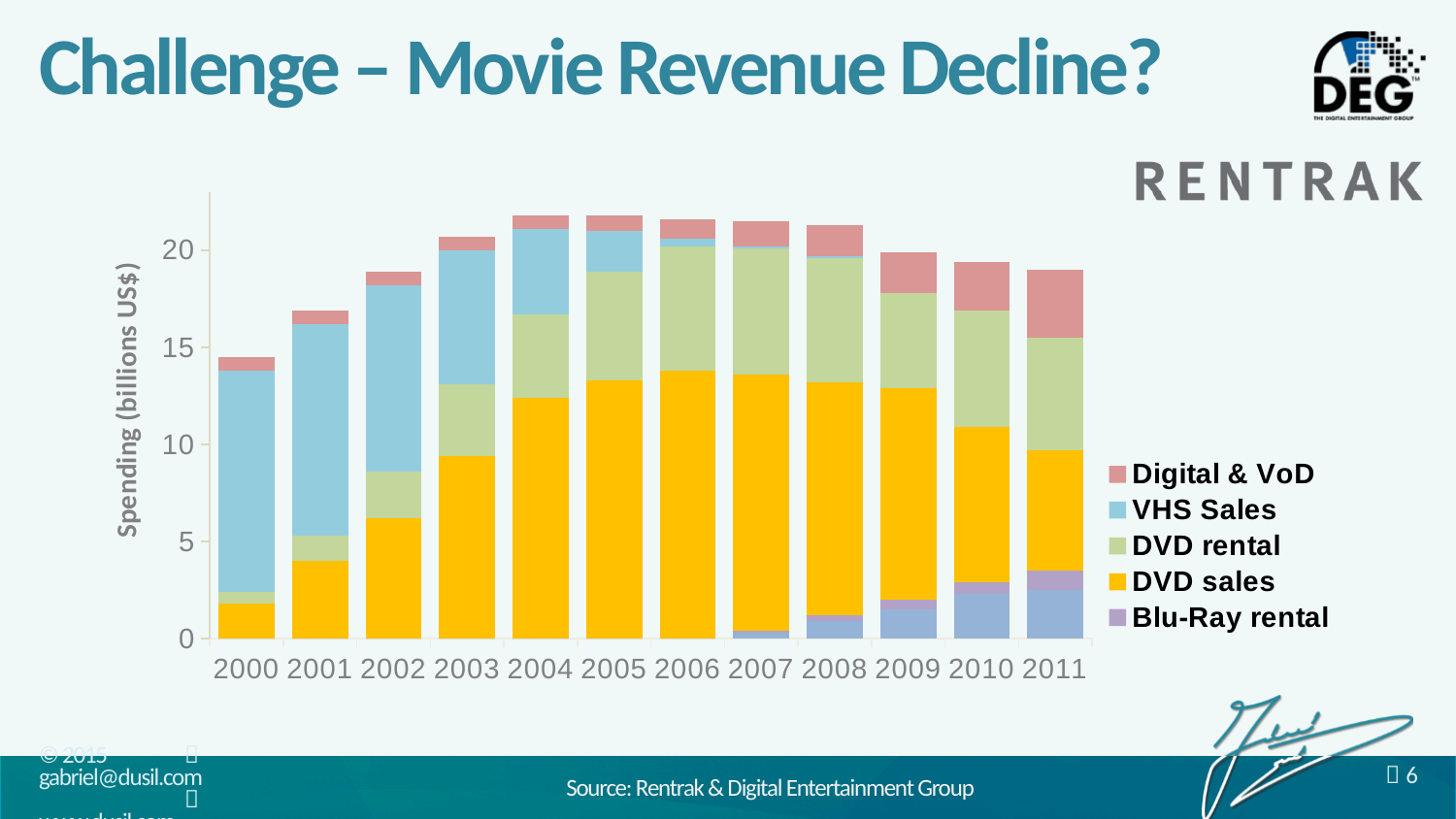
How many years are shown along the x axis of the chart? 12 What is the label on the y axis of the chart? Spending (billions US$) Which year has the lowest total spending? 2000 Is the total spending for 2011 greater or less than 20? less Is the total spending for 2004 greater or less than 20? greater Is the total spending for 2002 greater or less than 15? greater What kind of chart is shown on the slide? Stacked bar chart Which series is listed first (at the top) in the chart's legend? Digital & VoD Which year has the larger total spending, 2000 or 2003? 2003 Do the total bar heights rise or fall from 2006 to 2011? Fall How many series does the chart's legend list? 5